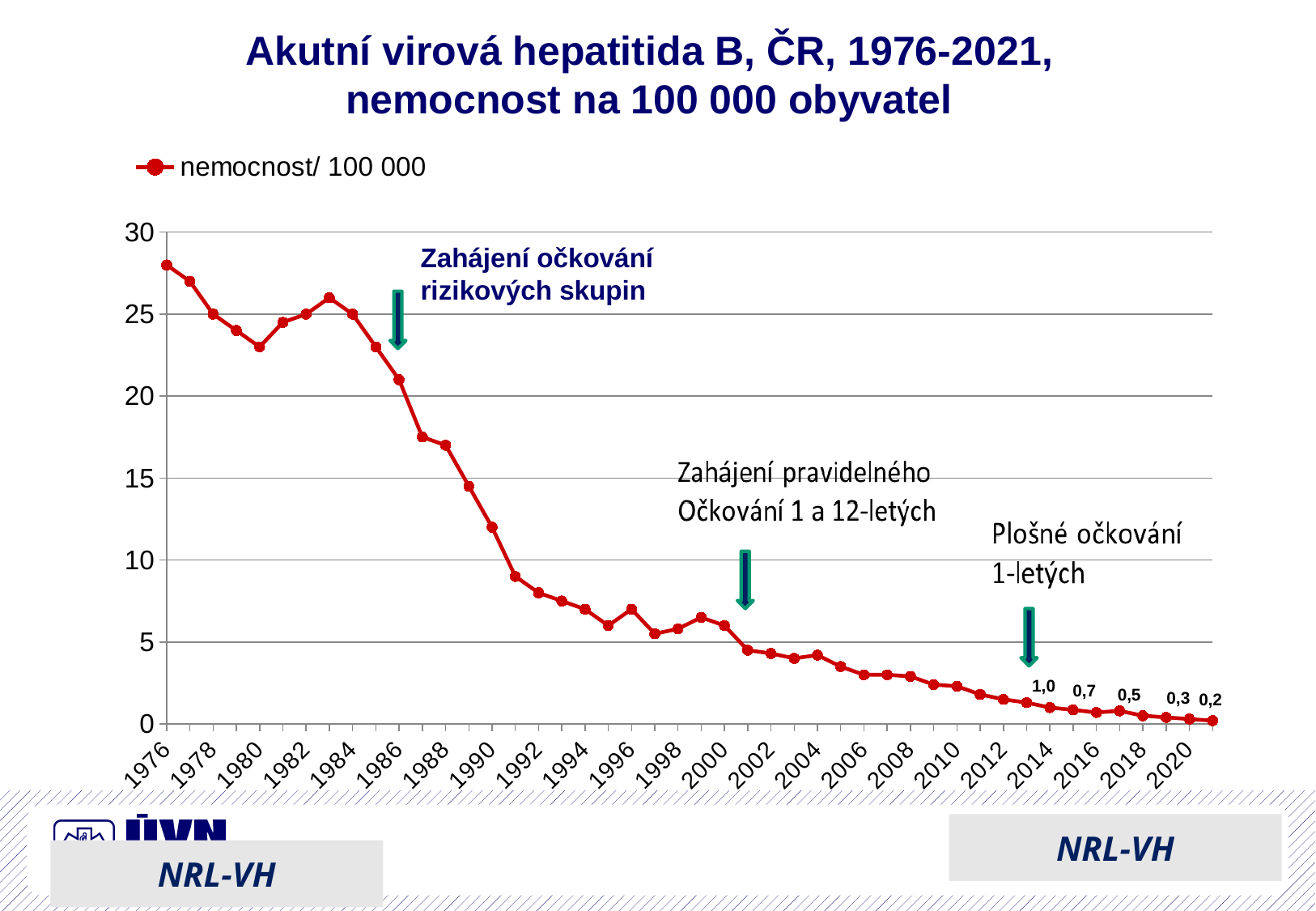
What is the legend entry for the plotted series? nemocnost/ 100 000 What is the difference between the values for 2014 and 2021? 0,8 How many series does the legend list? 1 What kind of chart is shown on the slide? line chart What is the value for 2021? 0,2 What is the value for 2014? 1,0 What is the value for 2016? 0,7 Do the values generally rise or fall from 1976 to 2021? fall Is the value for 1976 greater or less than 25? greater What is the value for 2018? 0,5 Which year has the larger value, 2016 or 2018? 2016 Is the value for 2002 greater or less than 5? less